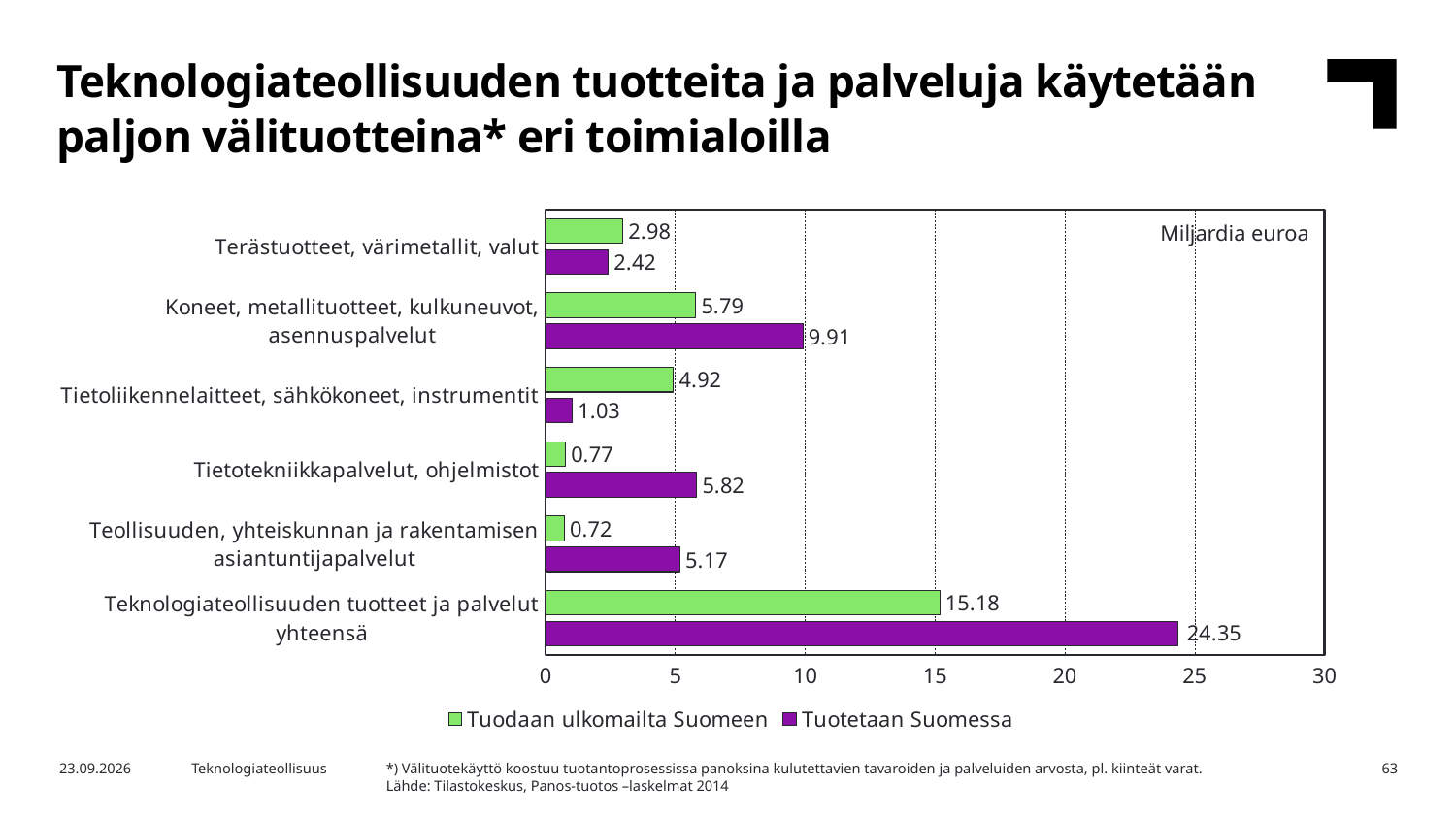
What is the value of "Tuotetaan Suomessa" for "Koneet, metallituotteet, kulkuneuvot, asennuspalvelut"? 9.91 Is the "Tuotetaan Suomessa" value for "Teknologiateollisuuden tuotteet ja palvelut yhteensä" greater or less than 20? greater What is the value of "Tuotetaan Suomessa" for "Tietotekniikkapalvelut, ohjelmistot"? 5.82 How many series does the legend list? 2 Which category has the highest "Tuotetaan Suomessa" value? Teknologiateollisuuden tuotteet ja palvelut yhteensä What is the value of "Tuodaan ulkomailta Suomeen" for "Tietoliikennelaitteet, sähkökoneet, instrumentit"? 4.92 For "Terästuotteet, värimetallit, valut", which is larger: "Tuodaan ulkomailta Suomeen" or "Tuotetaan Suomessa"? Tuodaan ulkomailta Suomeen How many categories are shown on the chart? 6 What is the difference between "Tuotetaan Suomessa" and "Tuodaan ulkomailta Suomeen" for "Teknologiateollisuuden tuotteet ja palvelut yhteensä"? 9.17 Which category has the lowest "Tuodaan ulkomailta Suomeen" value? Teollisuuden, yhteiskunnan ja rakentamisen asiantuntijapalvelut What kind of chart is shown on the slide? Bar chart What unit is indicated in the top right corner of the chart? Miljardia euroa